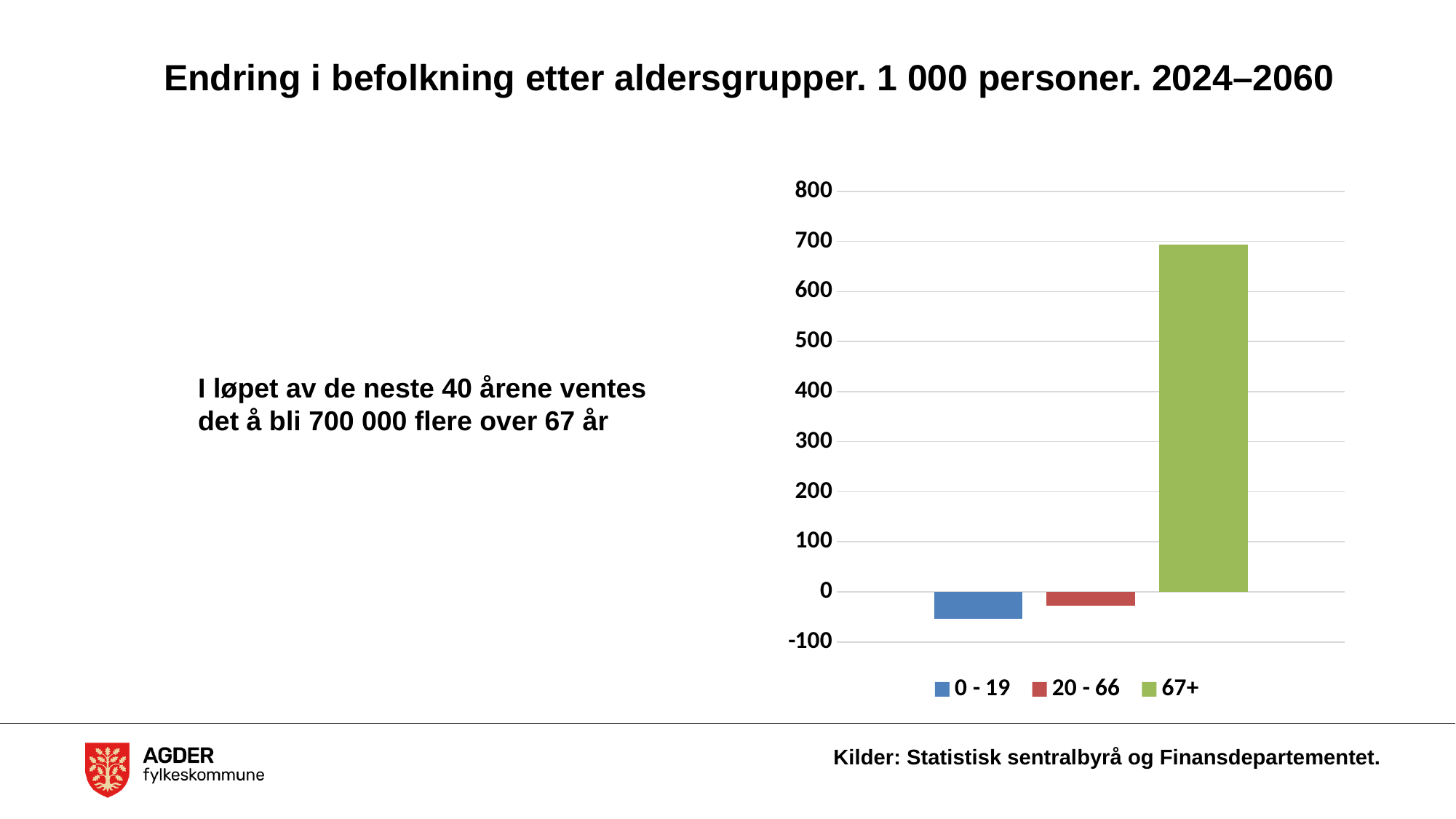
Which age group has the lowest value in the chart? 0 - 19 Which is larger, the value for 0 - 19 or the value for 20 - 66? 20 - 66 Is the value for 0 - 19 greater or less than 0? less Is the value for 20 - 66 greater or less than 0? less Which age group has the highest value in the chart? 67+ What colour is the bar for the 67+ age group? green Is the value for 67+ greater or less than 600? greater What kind of chart is shown on the slide? bar chart How many bars are plotted in the chart? 3 How many series does the legend list? 3 What is the title of the chart on the slide? Endring i befolkning etter aldersgrupper. 1 000 personer. 2024–2060